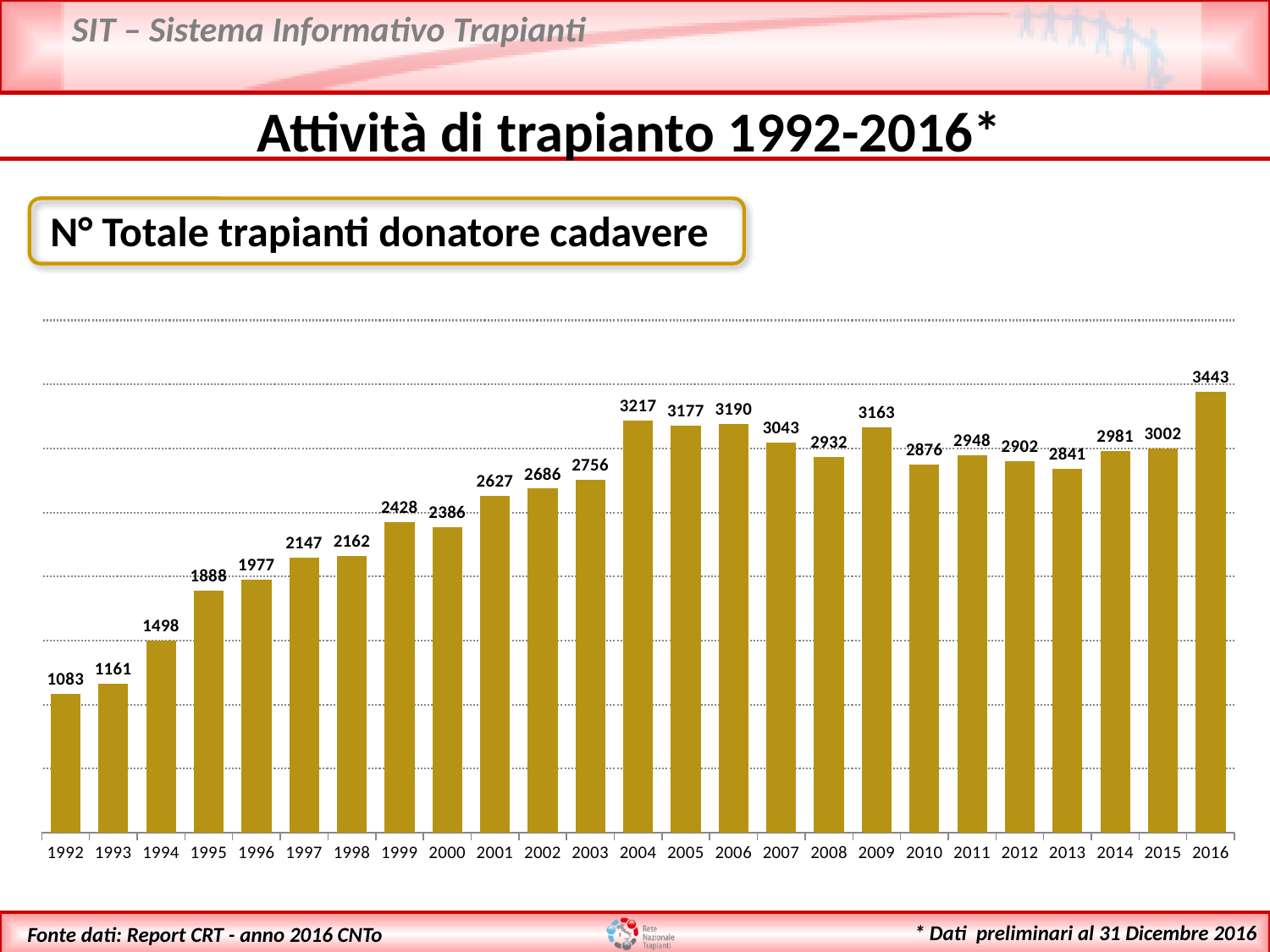
What is the value for 1992? 1083 Which year has the highest value? 2016 What is the difference between the values for 1994 and 1993? 337 What is the value for 2016? 3443 What kind of chart is shown on the slide? Bar chart Which is larger, the value for 2004 or the value for 2009? 2004 What is the title shown in the box above the chart? N° Totale trapianti donatore cadavere Which year has the lowest value? 1992 How many years are shown on the x axis? 25 What is the difference between the values for 2016 and 2015? 441 What is the value for 2010? 2876 What is the value for 2004? 3217